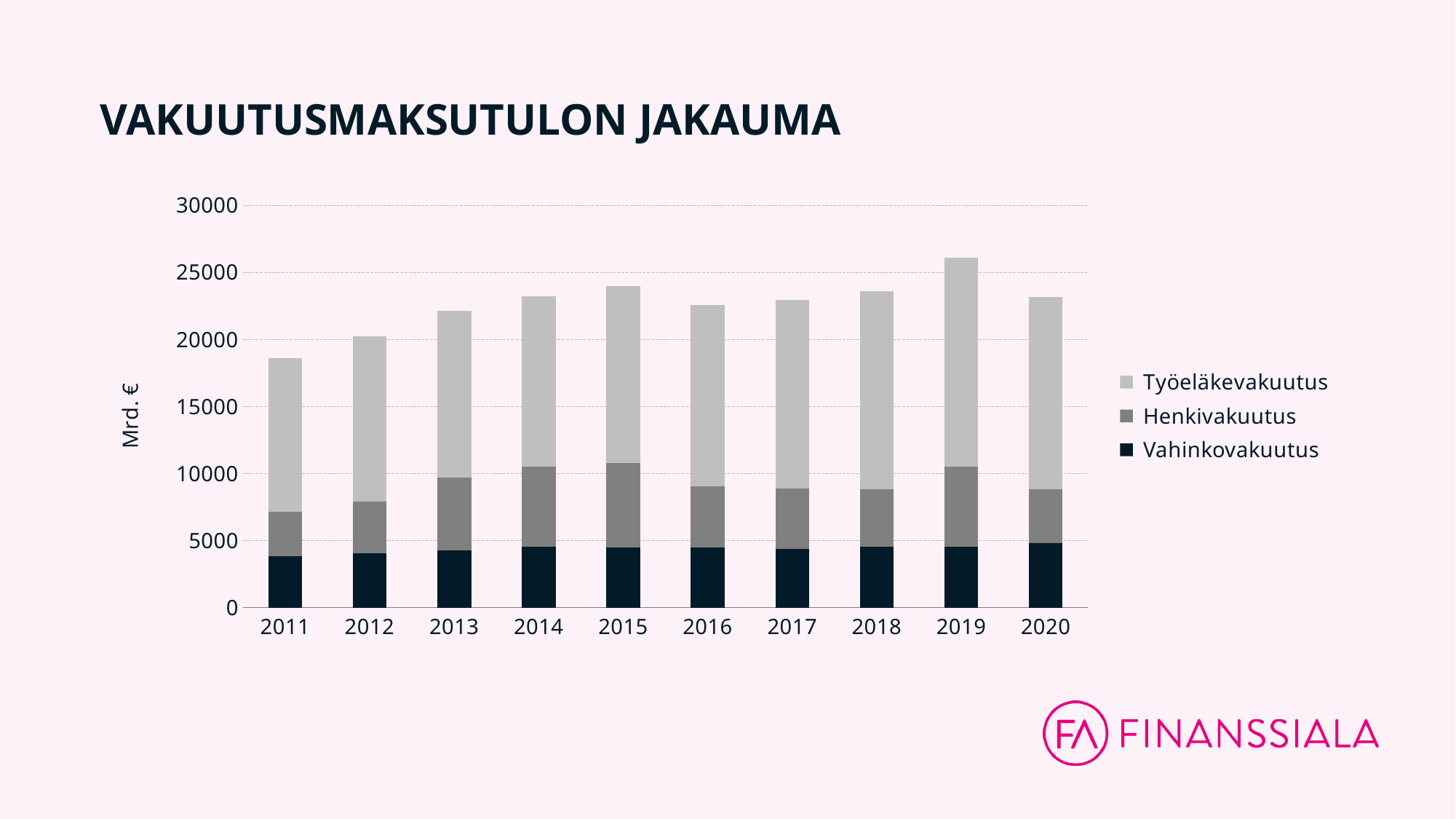
Is the total bar for 2015 greater or less than 25000? less How many series does the legend list? 3 Is the total bar for 2011 greater or less than 20000? less What is the label on the vertical axis? Mrd. € Is the Vahinkovakuutus value for 2011 greater or less than 5000? less What is the title of the chart? VAKUUTUSMAKSUTULON JAKAUMA Do the total bars rise or fall from 2011 to 2015? rise What kind of chart is shown on the slide? Stacked bar chart How many years are shown on the x axis of the chart? 10 Which year has the highest total bar? 2019 Which year has the lowest total bar? 2011